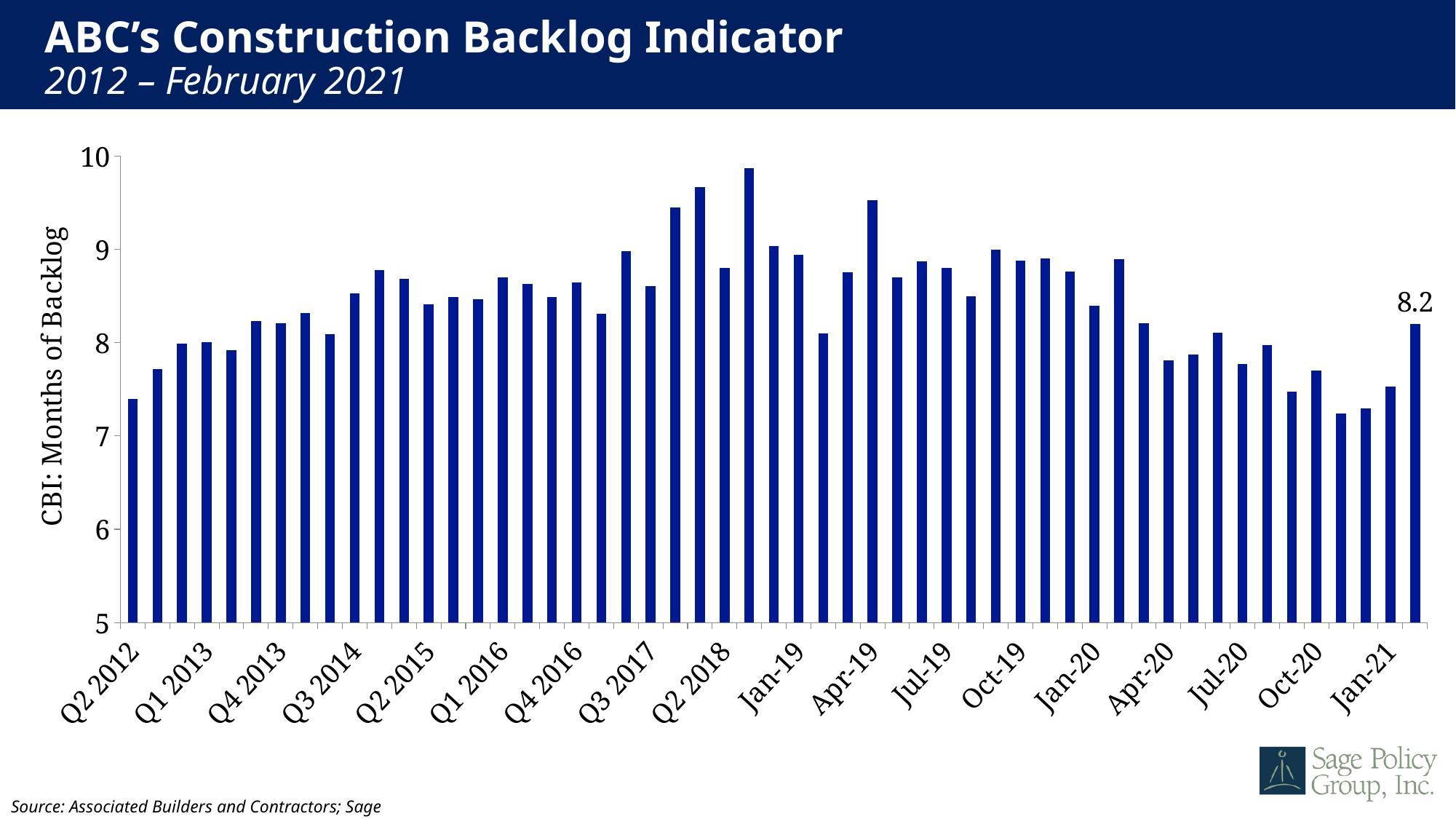
Is the value for Apr-19 greater or less than 9? greater Which is larger, the value for Apr-19 or the value for Apr-20? Apr-19 Is the value for Oct-20 greater or less than 8? less Do the values generally rise or fall from Q2 2012 to Q2 2018? rise What value is printed as a data label on the rightmost bar of the chart? 8.2 Is the value for Q2 2012 greater or less than 8? less Which is larger, the value for Q2 2012 or the value for Q2 2018? Q2 2018 What kind of chart is shown on the slide? bar chart What is the title of the vertical axis? CBI: Months of Backlog